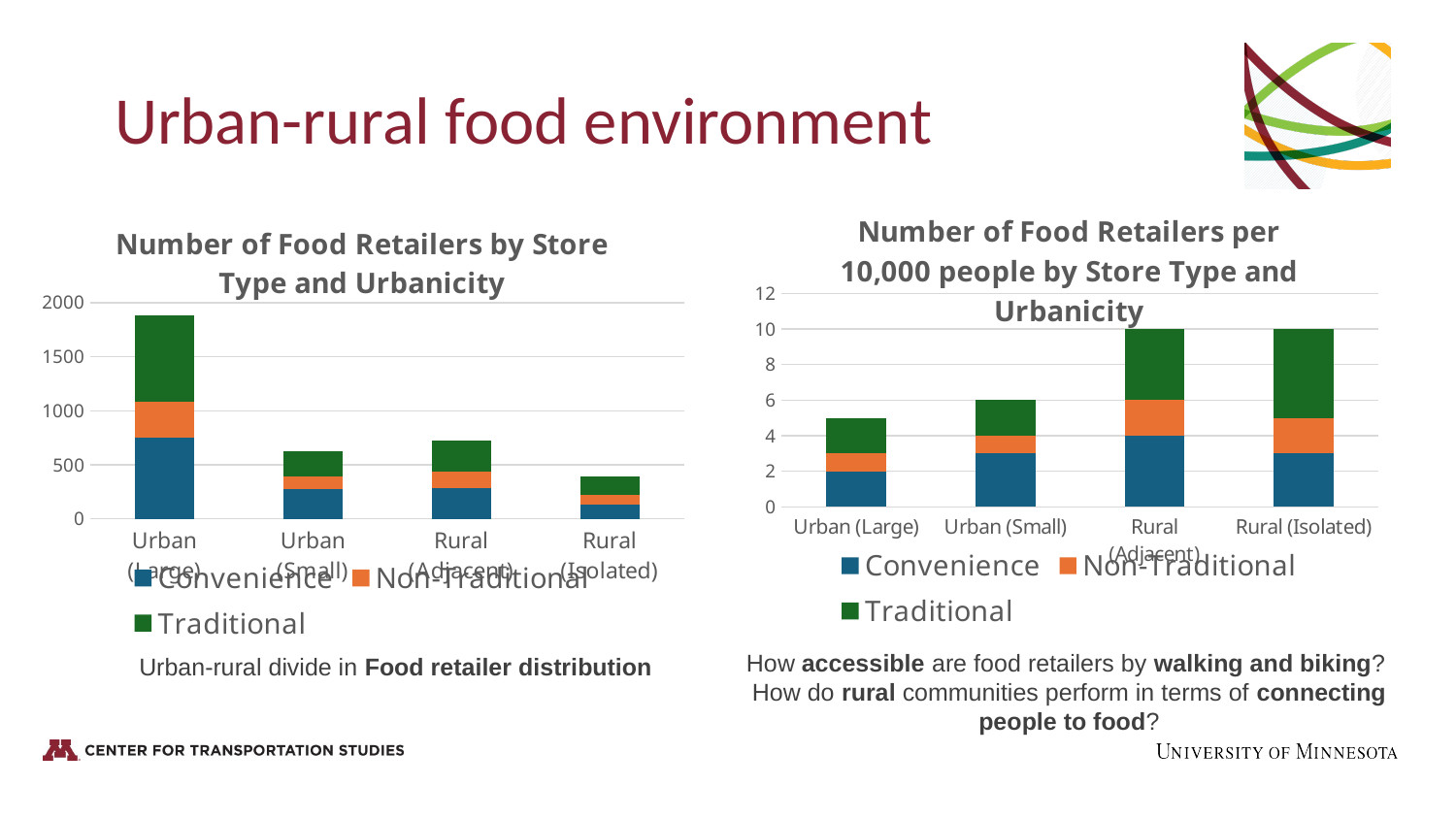
What type of chart is the left chart, 'Number of Food Retailers by Store Type and Urbanicity'? Stacked bar chart In the right chart, 'Number of Food Retailers per 10,000 people by Store Type and Urbanicity', which has a larger total: Urban (Small) or Rural (Isolated)? Rural (Isolated) In the left chart, 'Number of Food Retailers by Store Type and Urbanicity', which has a larger total: Urban (Small) or Rural (Adjacent)? Rural (Adjacent) How many series does the legend of the right chart, 'Number of Food Retailers per 10,000 people by Store Type and Urbanicity', list? 3 In the right chart, 'Number of Food Retailers per 10,000 people by Store Type and Urbanicity', which category has the lowest total? Urban (Large) In the left chart, 'Number of Food Retailers by Store Type and Urbanicity', is the total for Rural (Isolated) greater or less than 500? less Which series is shown in green in the legend of the right chart, 'Number of Food Retailers per 10,000 people by Store Type and Urbanicity'? Traditional In the right chart, 'Number of Food Retailers per 10,000 people by Store Type and Urbanicity', is the total for Rural (Adjacent) greater or less than 8? greater In the left chart, 'Number of Food Retailers by Store Type and Urbanicity', is the total for Urban (Large) greater or less than 1500? greater In the left chart, 'Number of Food Retailers by Store Type and Urbanicity', which category has the highest total number of food retailers? Urban (Large) How many urbanicity categories are shown on the x axis of the left chart, 'Number of Food Retailers by Store Type and Urbanicity'? 4 In the left chart, 'Number of Food Retailers by Store Type and Urbanicity', which category has the lowest total number of food retailers? Rural (Isolated)